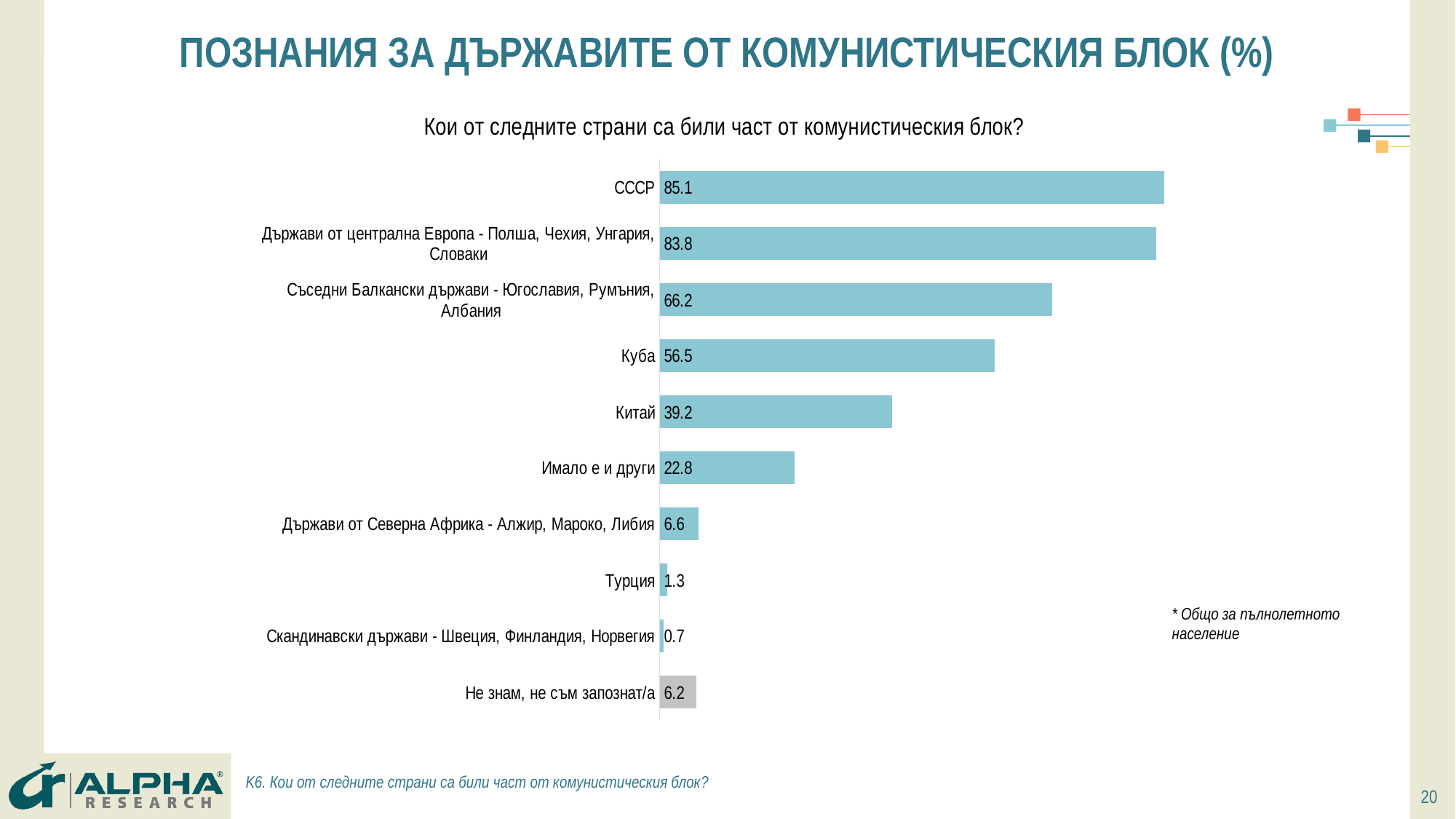
What is the difference between the values for Китай and Имало е и други? 16.4 What is the difference between the values for СССР and Куба? 28.6 How many categories are shown in the chart? 10 What value is shown for СССР? 85.1 Which category has the highest value? СССР What value is shown for Куба? 56.5 Which is larger, the value for Държави от Северна Африка - Алжир, Мароко, Либия or the value for Не знам, не съм запознат/а? Държави от Северна Африка - Алжир, Мароко, Либия Which category has the lowest value? Скандинавски държави - Швеция, Финландия, Норвегия What kind of chart is shown on the slide? bar chart Which bar is shown in a different colour (grey) from the others? Не знам, не съм запознат/а What value is shown for Турция? 1.3 What value is shown for Китай? 39.2